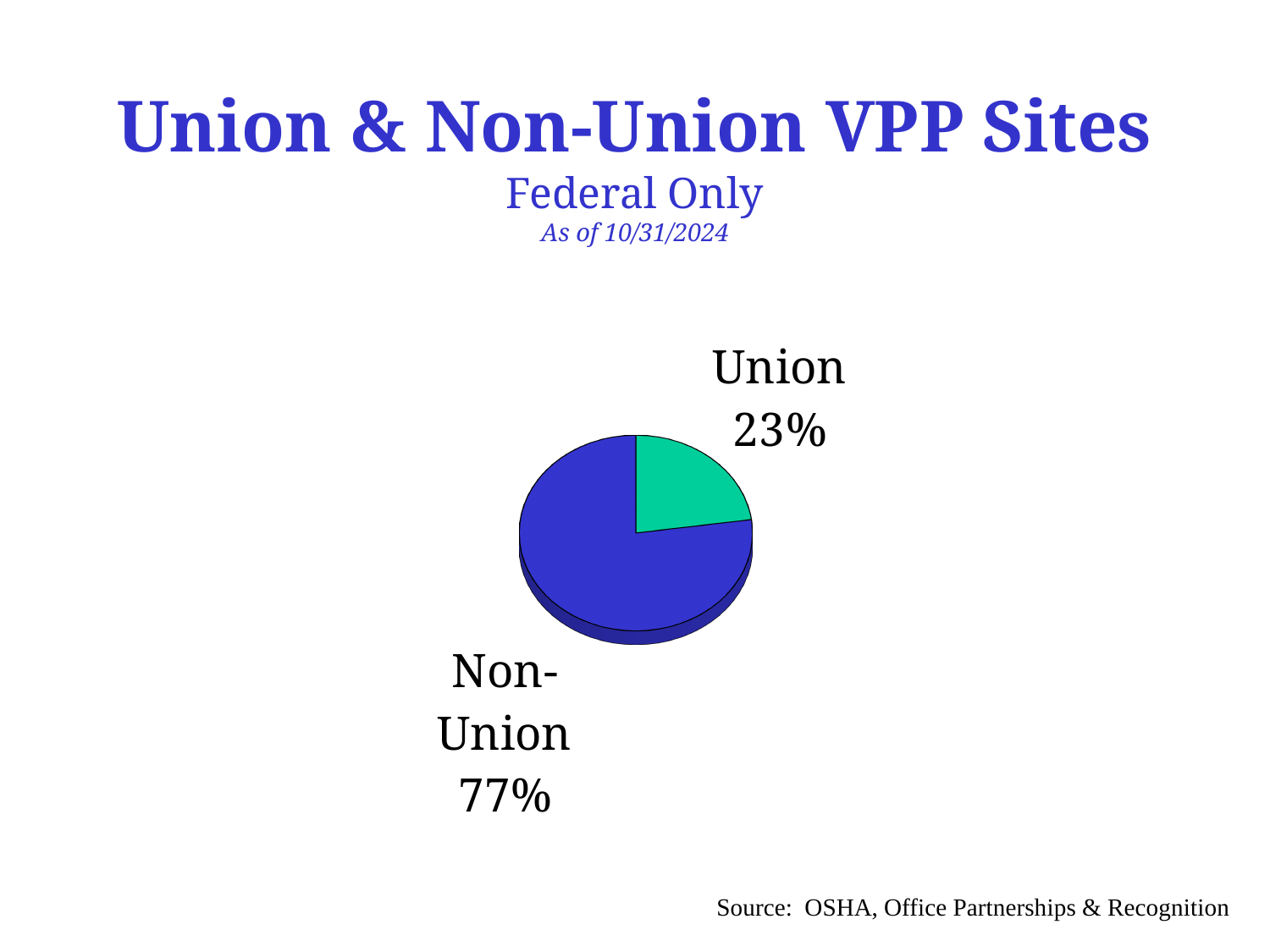
Which category has the largest share of the pie? Non-Union What kind of chart is shown on the slide? Pie chart Is the Non-Union share greater or less than 50%? greater Which is larger, the Union share or the Non-Union share? Non-Union What percentage of Federal VPP sites are Union? 23% What percentage of Federal VPP sites are Non-Union? 77% What colour is the Union slice of the pie? Green How many slices does the pie chart have? 2 Which category has the smallest share of the pie? Union What share of the pie does the Union slice represent? 23% What is the title of the chart on the slide? Union & Non-Union VPP Sites What is the difference in percentage points between the Non-Union and Union shares? 54